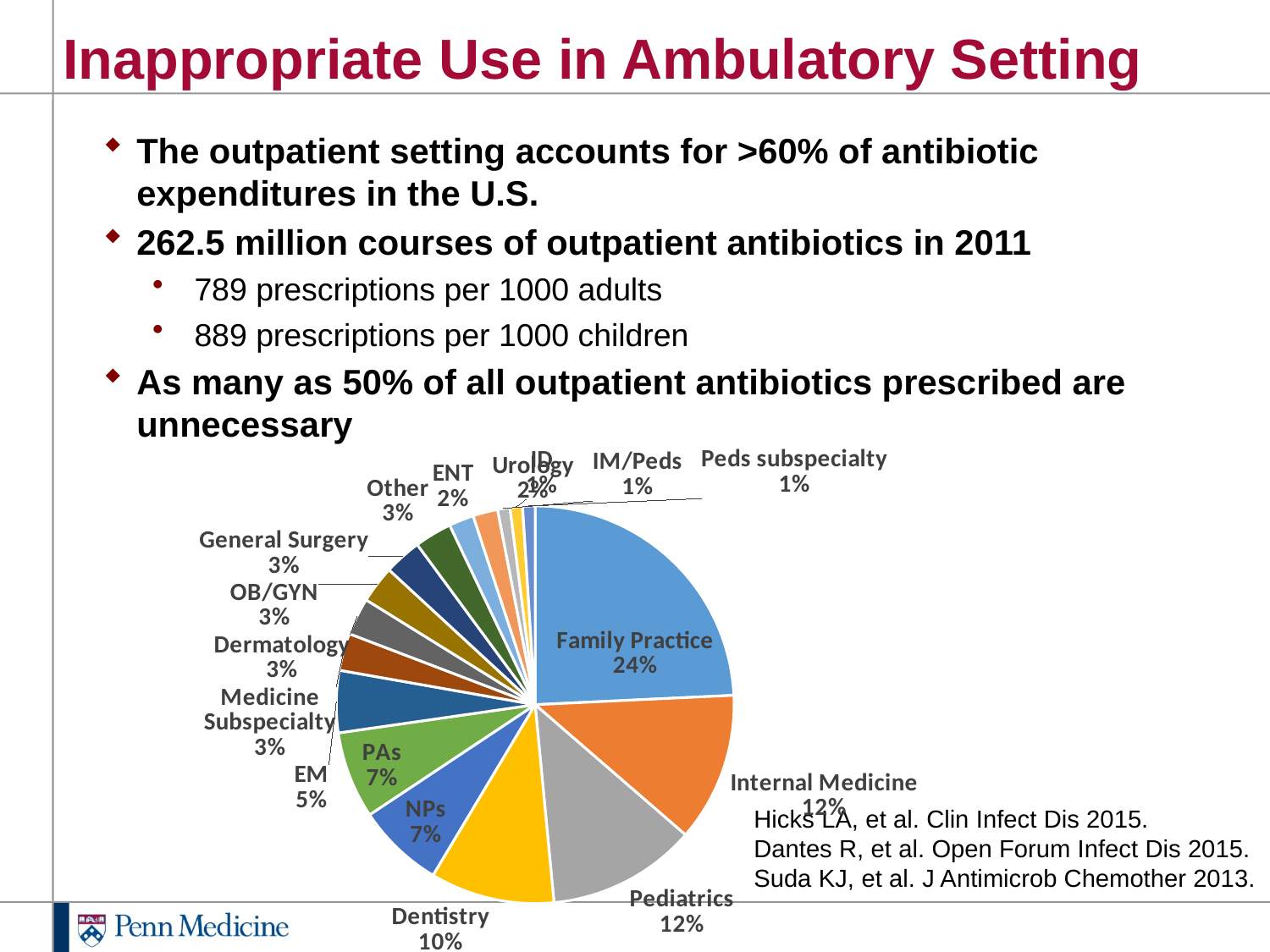
How many slices does the pie chart have? 17 Which category has the largest slice of the pie? Family Practice What is the value shown for EM? 5% What is the value shown for General Surgery? 3% What is the value shown for Internal Medicine? 12% What kind of chart is shown on the slide? pie chart What is the value shown for NPs? 7% Which is larger, the share for Dentistry or the share for EM? Dentistry What share of the pie does Family Practice account for? 24% What is the difference between the Family Practice share and the Pediatrics share? 12% What is the value shown for Dentistry? 10% What is the value shown for ENT? 2%